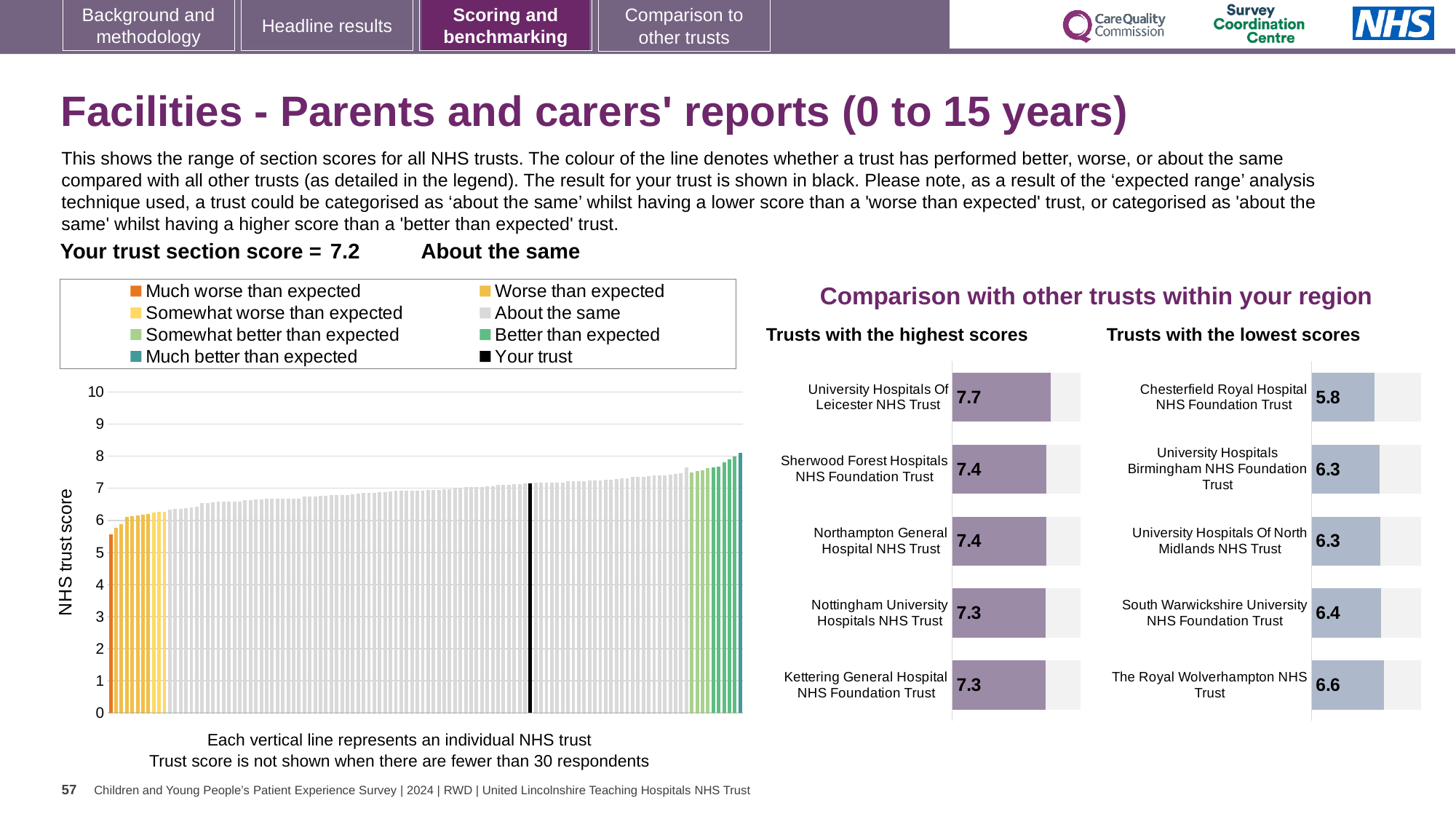
In the 'Trusts with the highest scores' chart, what is the difference between the scores of University Hospitals Of Leicester NHS Trust and Kettering General Hospital NHS Foundation Trust? 0.4 In the 'Trusts with the highest scores' chart, which trust has the highest score? University Hospitals Of Leicester NHS Trust How many entries does the legend of the large chart on the left list? 8 In the 'Trusts with the highest scores' chart, what is the score for University Hospitals Of Leicester NHS Trust? 7.7 How many trusts are shown in the 'Trusts with the highest scores' chart? 5 In the 'Trusts with the lowest scores' chart, what is the difference between the scores of The Royal Wolverhampton NHS Trust and Chesterfield Royal Hospital NHS Foundation Trust? 0.8 In the 'Trusts with the lowest scores' chart, which trust has the lowest score? Chesterfield Royal Hospital NHS Foundation Trust In the 'Trusts with the lowest scores' chart, what is the score for Chesterfield Royal Hospital NHS Foundation Trust? 5.8 In the 'Trusts with the highest scores' chart, which has the higher score: Sherwood Forest Hospitals NHS Foundation Trust or Nottingham University Hospitals NHS Trust? Sherwood Forest Hospitals NHS Foundation Trust What kind of chart is the large chart on the left showing the range of NHS trust scores? bar chart In the 'Trusts with the lowest scores' chart, what is the score for The Royal Wolverhampton NHS Trust? 6.6 In the large chart on the left, is the value for 'Your trust' greater or less than 5? greater